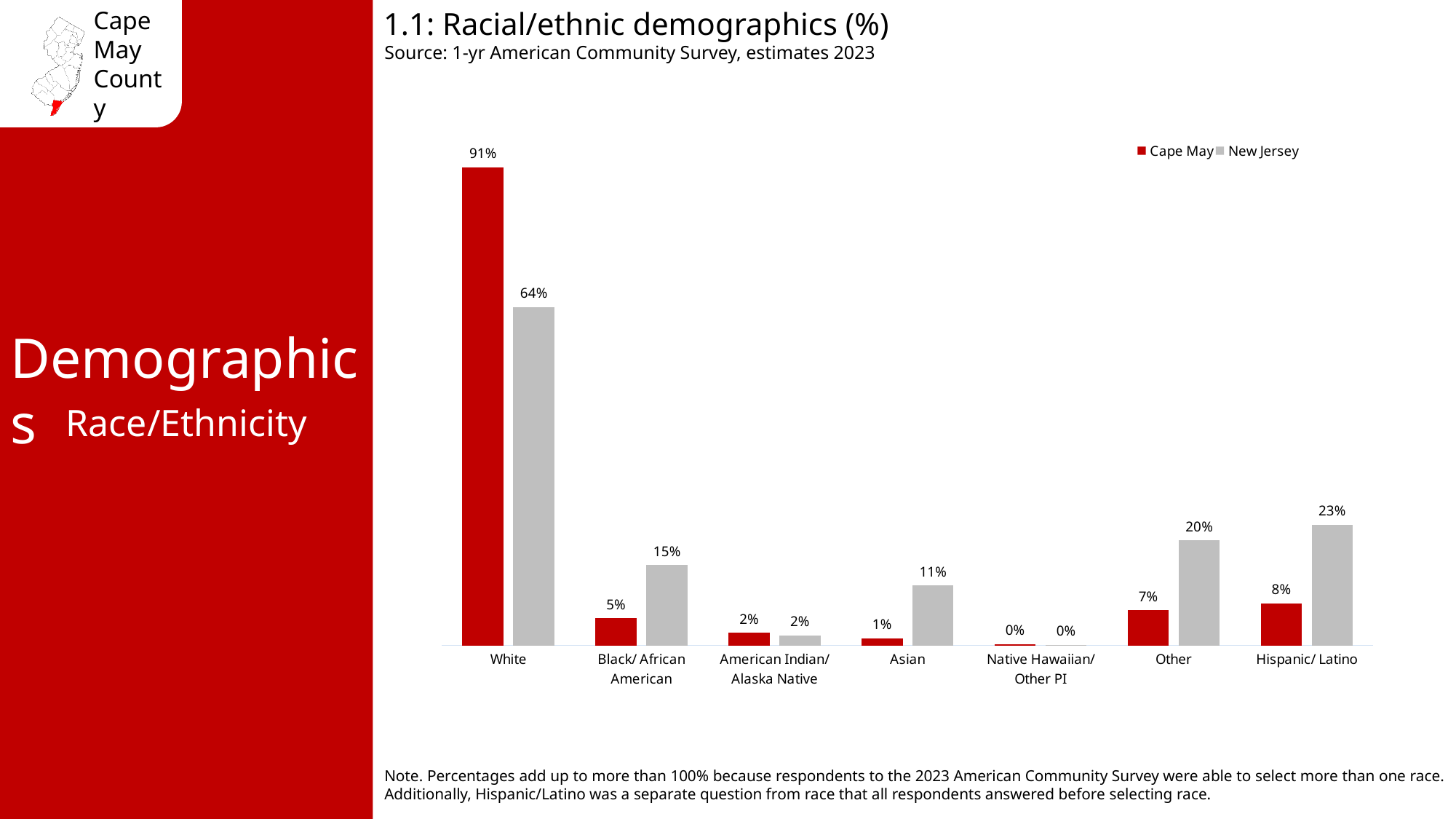
What kind of chart is shown on the slide? Bar chart What is the difference between the New Jersey and Cape May values for Asian? 10% What is the Cape May value for Other? 7% What is the New Jersey value for Hispanic/ Latino? 23% What is the New Jersey value for Black/ African American? 15% Which category has the lowest New Jersey value? Native Hawaiian/ Other PI How many categories are shown on the x axis? 7 What is the difference between the Cape May and New Jersey values for White? 27% What is the Cape May value for White? 91% How many series does the legend list? 2 Which category has the highest Cape May value? White Which is larger for Hispanic/ Latino, the Cape May value or the New Jersey value? New Jersey